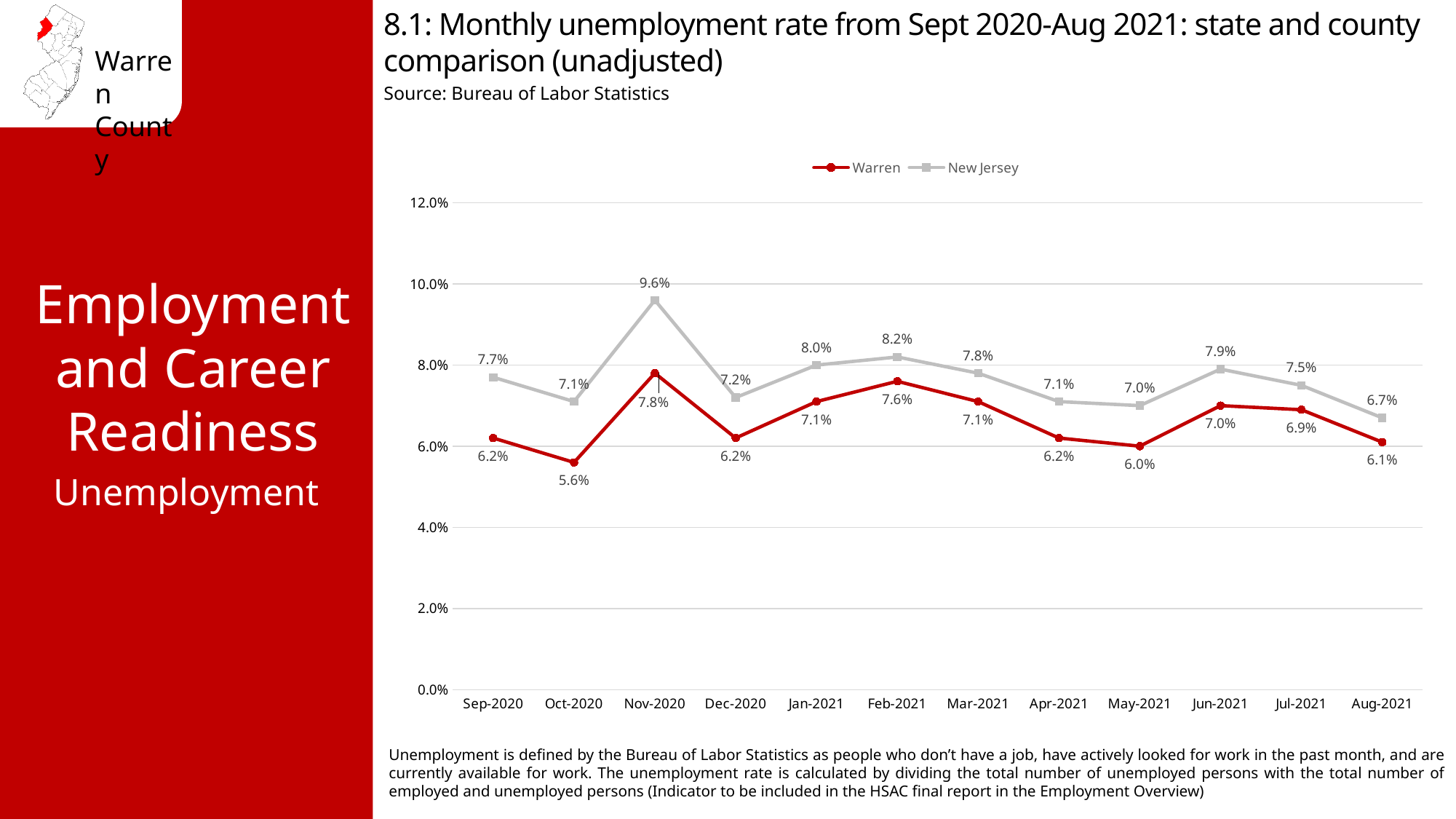
How many months are plotted on the x axis? 12 How many series does the legend list? 2 In which month did Warren have its lowest unemployment rate? Oct-2020 What was the Warren unemployment rate in Nov-2020? 7.8% Which series had the higher unemployment rate in Jan-2021, Warren or New Jersey? New Jersey What is the source cited for the chart? Bureau of Labor Statistics Did the Warren unemployment rate rise or fall from Jun-2021 to Aug-2021? Fall What was the New Jersey unemployment rate in Feb-2021? 8.2% What is the difference between the New Jersey and Warren unemployment rates in Nov-2020? 1.8% What type of chart is shown? Line chart In which month did New Jersey have its highest unemployment rate? Nov-2020 What colour is the Warren line? Red